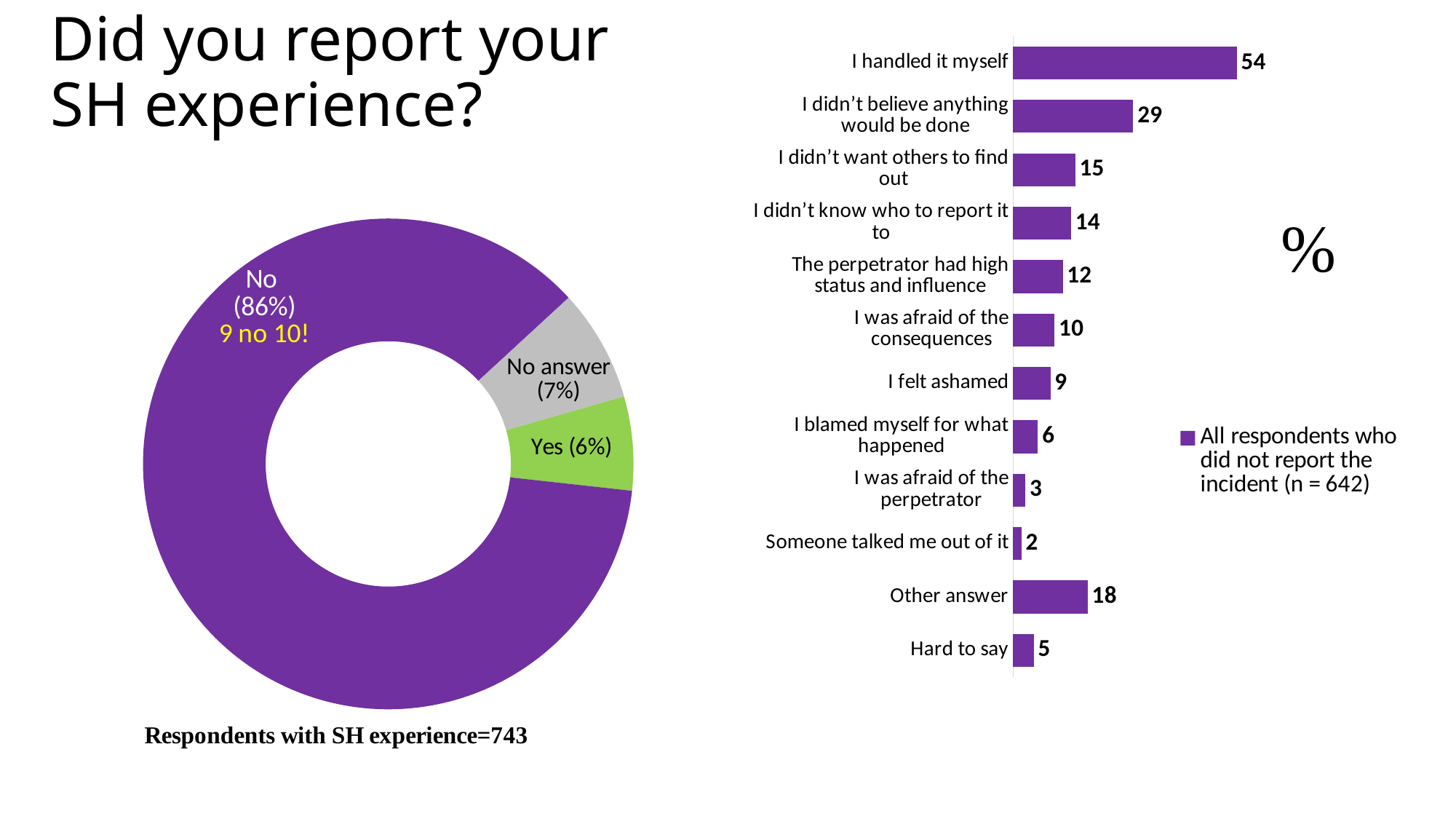
In the bar chart on the right, what is the value for "I felt ashamed"? 9 In the bar chart on the right, which category has the lowest value? Someone talked me out of it In the bar chart on the right, what is the difference between "I handled it myself" and "I didn't believe anything would be done"? 25 In the donut chart on the left, what share of respondents answered "Yes"? 6% In the bar chart on the right, how many categories are shown? 12 In the donut chart on the left, how many slices are there? 3 In the donut chart on the left, what share of respondents answered "No"? 86% In the bar chart on the right, what series does the legend list? All respondents who did not report the incident (n = 642) In the bar chart on the right, which is larger: "Other answer" or "I didn't want others to find out"? Other answer In the bar chart on the right, which category has the highest value? I handled it myself In the donut chart on the left, what share of respondents gave no answer? 7% In the bar chart on the right, what is the value for "I handled it myself"? 54